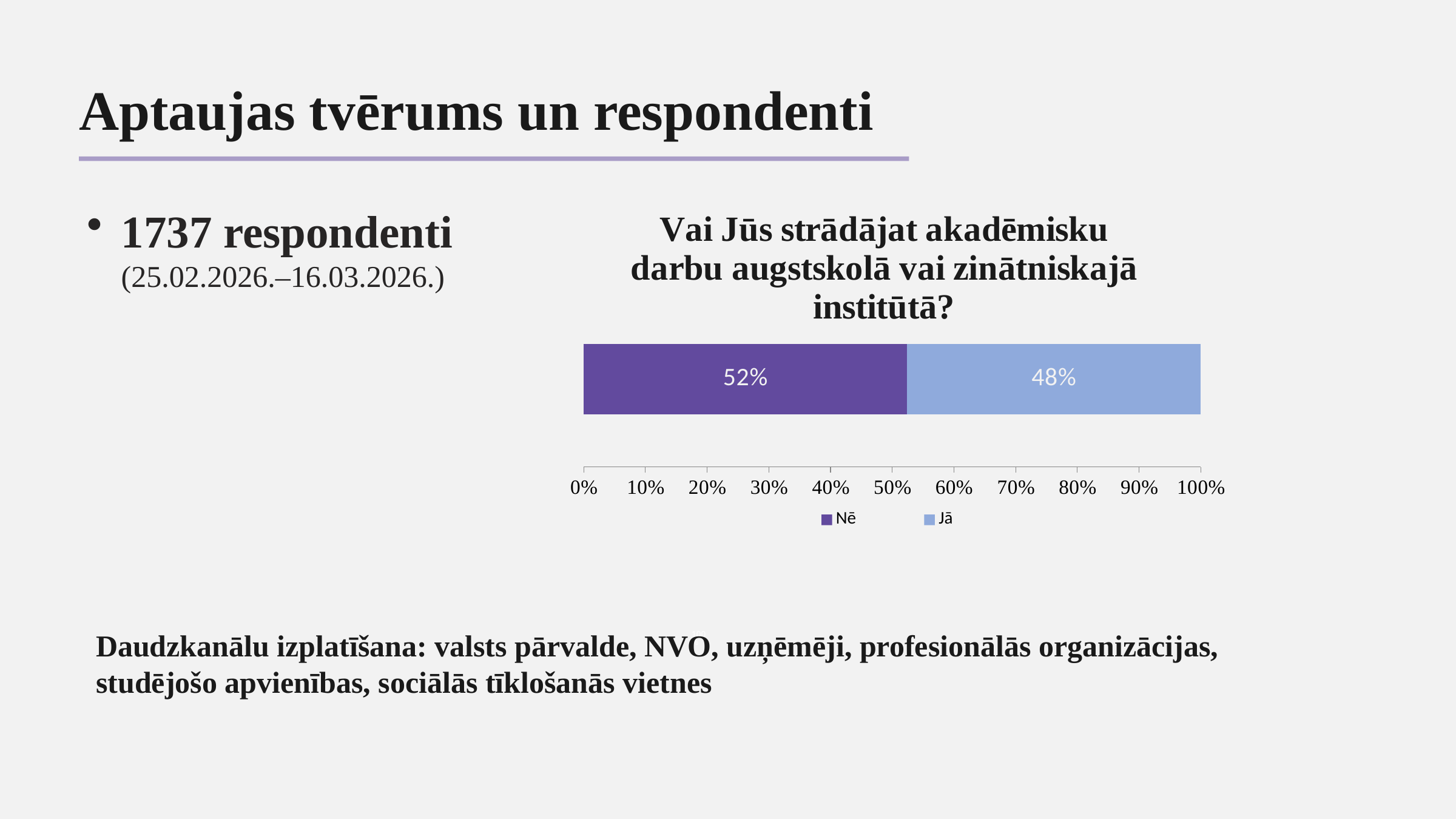
Which answer has the larger share in the chart, "Nē" or "Jā"? Nē What percentage of respondents answered "Jā" in the chart? 48% Which answer has the smallest share in the chart? Jā How many series does the chart legend list? 2 Is the value for "Jā" greater or less than 50%? less What percentage of respondents answered "Nē" in the chart? 52% What is the difference in percentage points between the "Nē" and "Jā" shares? 4 Which legend entry is shown in the darker purple colour? Nē What is the title of the chart? Vai Jūs strādājat akadēmisku darbu augstskolā vai zinātniskajā institūtā? What kind of chart is shown on the slide? Stacked bar chart Is the value for "Nē" greater or less than 50%? greater What is the total of the two segments in the stacked bar? 100%